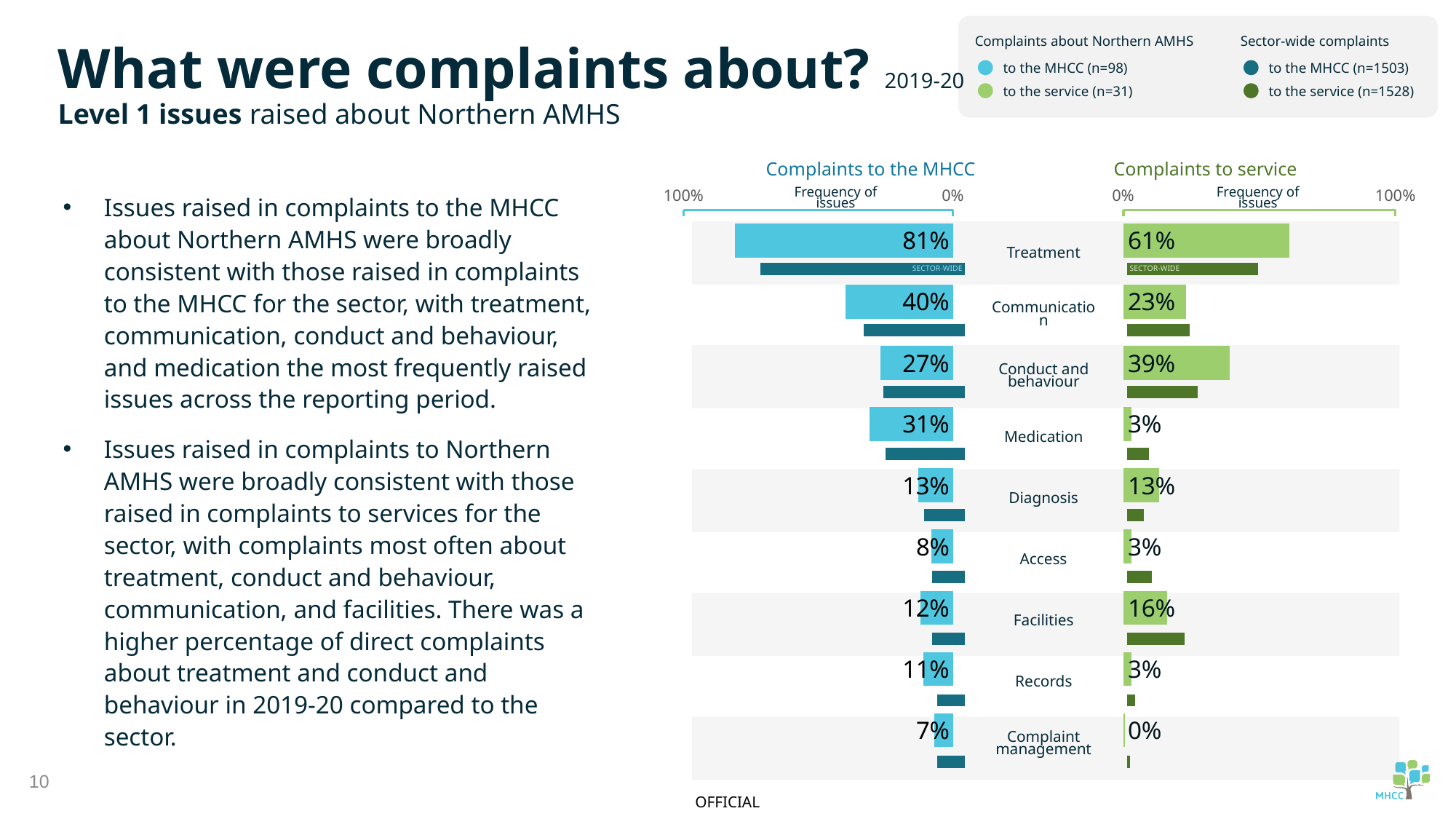
In the 'Complaints to service' chart, which issue has the lowest value? Complaint management What kind of chart is shown on the slide? Bar chart How many series does the legend list? 4 In the 'Complaints to the MHCC' chart, which issue has the lowest value? Complaint management In the 'Complaints to the MHCC' chart, what is the value for Medication? 31% In the 'Complaints to the MHCC' chart, what is the value for Treatment? 81% How many issue categories are shown in the chart? 9 In the 'Complaints to the MHCC' chart, what is the difference between Communication and Medication? 9% For Conduct and behaviour, which is larger: the 'Complaints to the MHCC' value or the 'Complaints to service' value? Complaints to service In the 'Complaints to service' chart, what is the value for Conduct and behaviour? 39% In the 'Complaints to service' chart, which issue has the highest value? Treatment What is the difference between the Treatment values in the 'Complaints to the MHCC' chart and the 'Complaints to service' chart? 20%